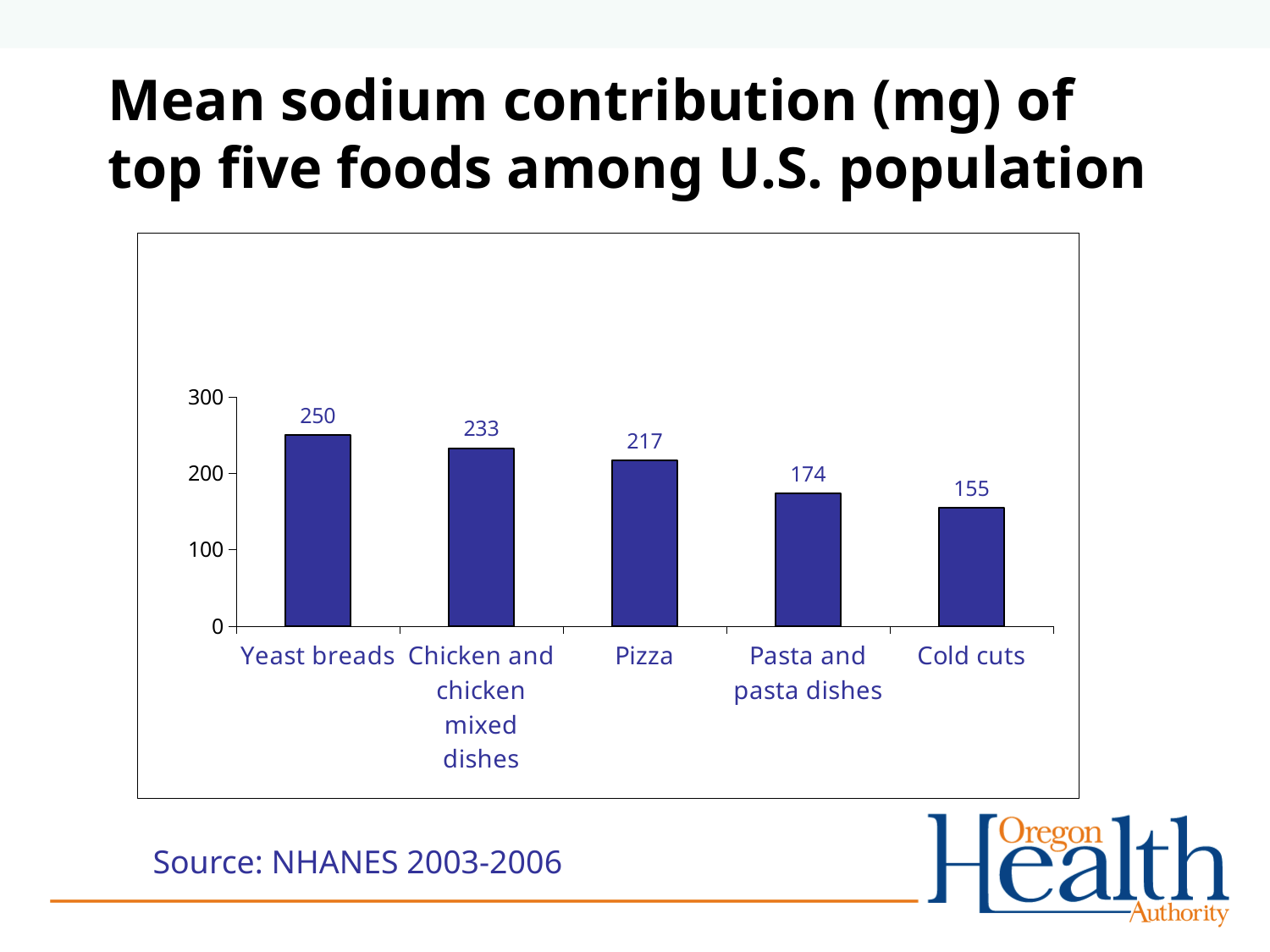
What kind of chart is shown on the slide? bar chart Which food has the highest mean sodium contribution? Yeast breads What is the difference between the values for Chicken and chicken mixed dishes and Pasta and pasta dishes? 59 What is the difference between the values for Yeast breads and Cold cuts? 95 What is the mean sodium contribution for Cold cuts? 155 Which is larger, the value for Pizza or the value for Pasta and pasta dishes? Pizza What is the mean sodium contribution for Pizza? 217 Which food has the lowest mean sodium contribution? Cold cuts Is the value for Pasta and pasta dishes greater or less than 200? less Do the values rise or fall from left to right across the chart? fall How many foods are shown in the chart? 5 What is the mean sodium contribution for Yeast breads? 250